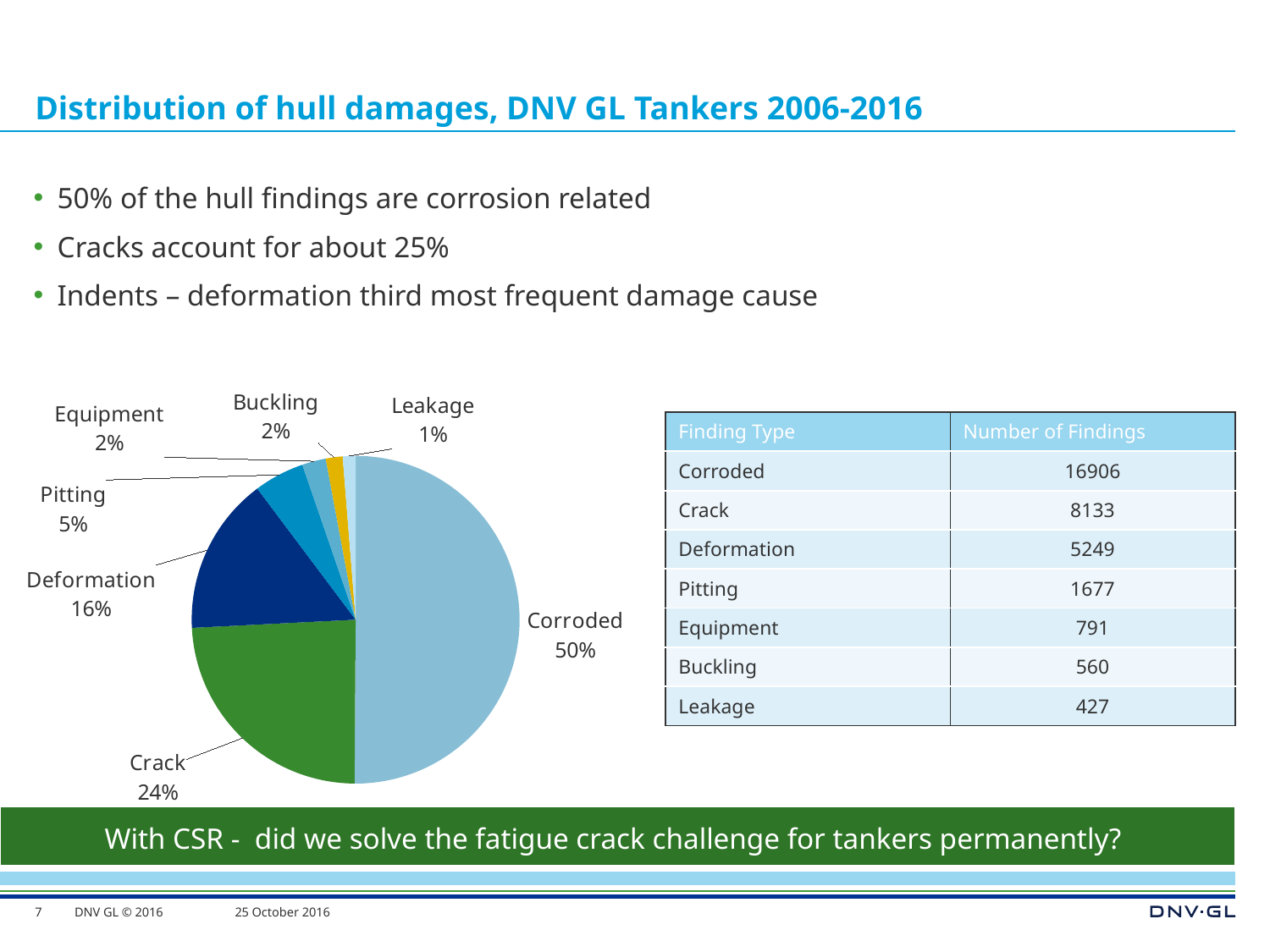
What percentage is shown for Pitting? 5% What share of the pie does Deformation account for? 16% Which finding type has the largest slice of the pie? Corroded What share of the pie does Crack account for? 24% What is the difference in percentage points between Corroded and Crack? 26% Which finding type has the smallest slice of the pie? Leakage What percentage is shown for Leakage? 1% What kind of chart is shown on the slide? pie chart What share of the pie does Corroded account for? 50% What is the title of the slide containing the pie chart? Distribution of hull damages, DNV GL Tankers 2006-2016 How many finding types are shown in the pie chart? 7 Which slice is larger, Deformation or Pitting? Deformation